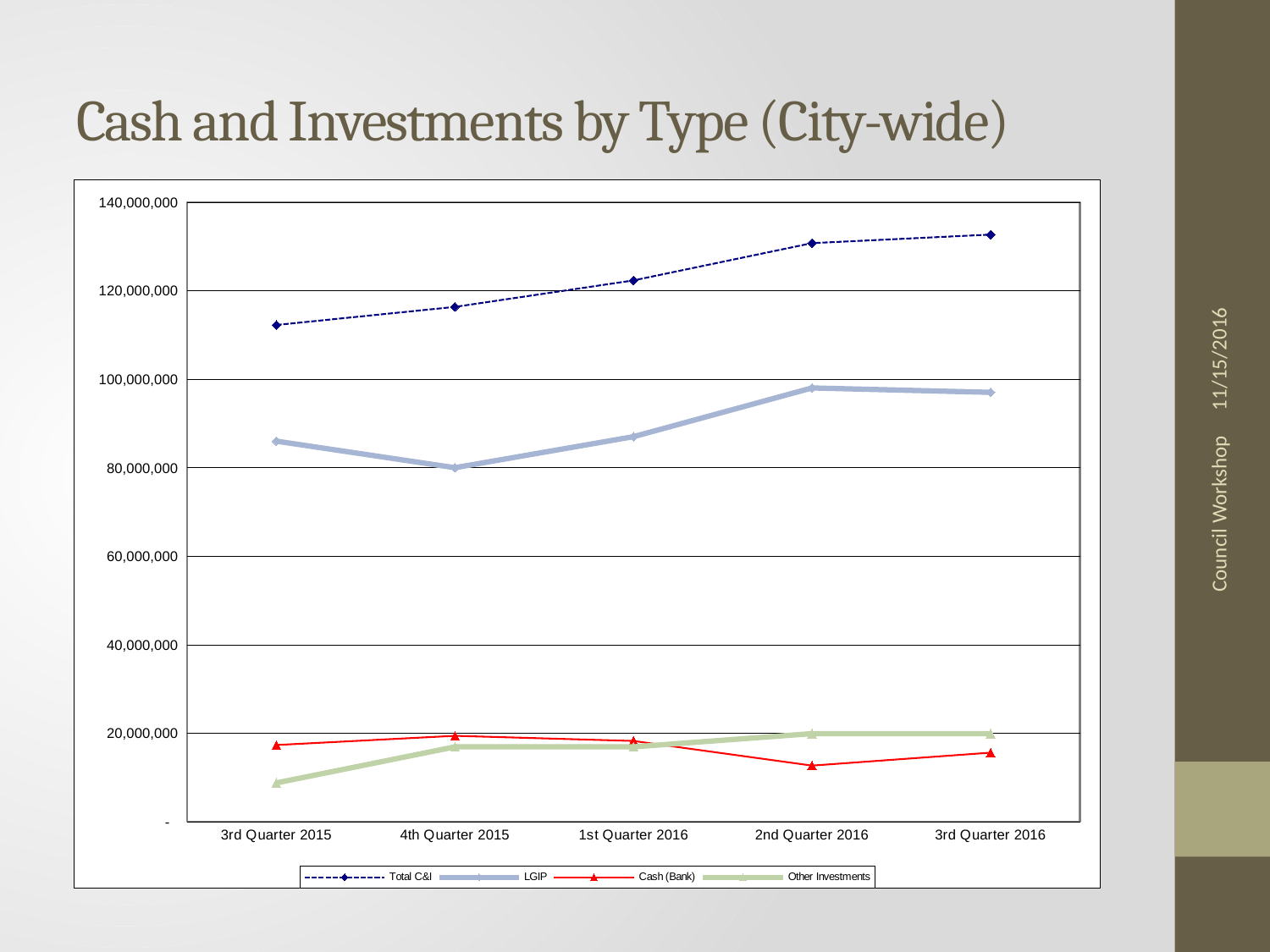
Does the Total C&I series rise or fall from 3rd Quarter 2015 to 3rd Quarter 2016? Rise How many series does the legend list? 4 Is the Other Investments value for 3rd Quarter 2015 greater or less than 20,000,000? less Is the Total C&I value for 3rd Quarter 2016 greater or less than 120,000,000? greater Is the Total C&I value for 3rd Quarter 2015 greater or less than 100,000,000? greater What kind of chart is shown on the slide? Line chart In 2nd Quarter 2016, which is larger: Cash (Bank) or Other Investments? Other Investments In which quarter is the Cash (Bank) value lowest? 2nd Quarter 2016 In which quarter is the LGIP value lowest? 4th Quarter 2015 How many quarters are plotted along the x axis? 5 In which quarter is the Total C&I value lowest? 3rd Quarter 2015